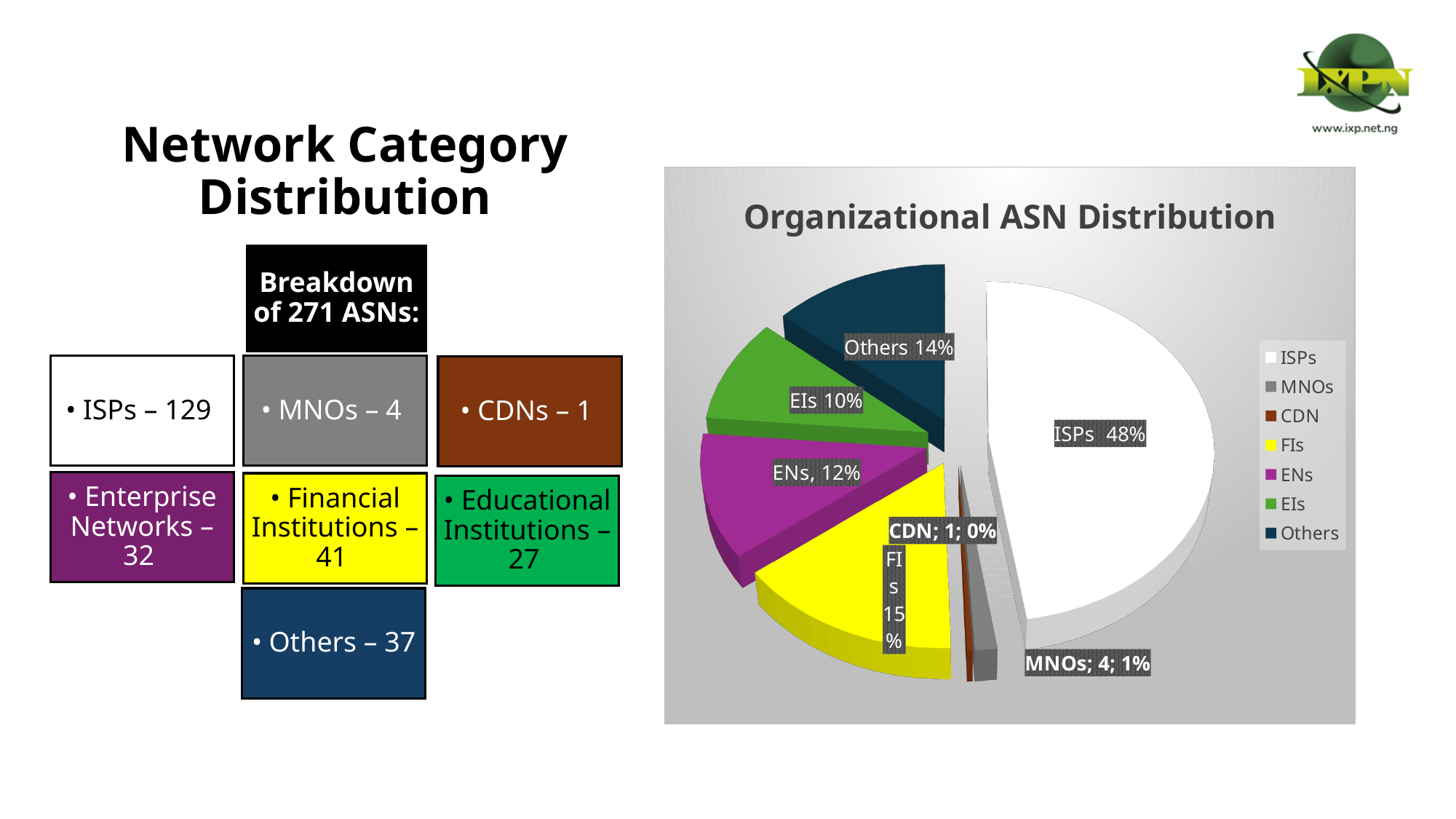
What percentage share does the ISPs slice have in the pie chart? 48% What percentage is shown for the Others slice? 14% How many categories does the legend of the pie chart list? 7 What count value is shown in the data label for MNOs? 4 Which category has the smallest share of the pie? CDN How many percentage points larger is the ISPs share than the FIs share? 33 What percentage is shown for the FIs slice? 15% What percentage is shown for the ENs slice? 12% What type of chart is shown on the slide? pie chart Which category has the largest share of the pie? ISPs What is the title of the chart? Organizational ASN Distribution What percentage is shown for the EIs slice? 10%